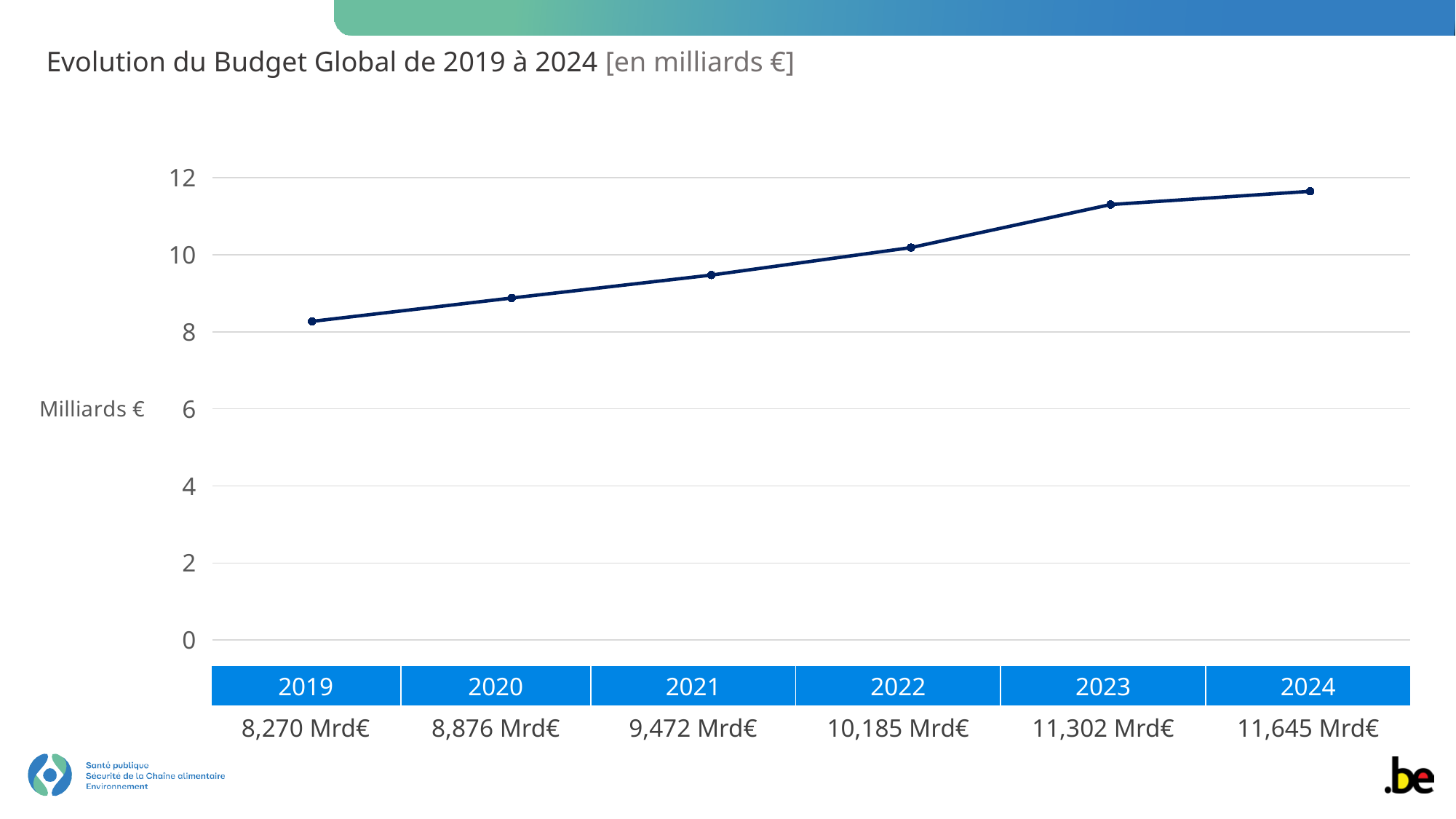
Does the global budget rise or fall from 2019 to 2024? rise What is the value of the global budget for 2024? 11,645 Mrd€ Which year has the lowest global budget? 2019 Which year has the highest global budget? 2024 What is the value of the global budget for 2022? 10,185 Mrd€ How many years are plotted on the chart? 6 Which year has a larger global budget, 2021 or 2023? 2023 What type of chart is shown on the slide? line chart Is the value for 2022 greater or less than 10? greater What is the difference between the global budget in 2024 and in 2019? 3,375 Mrd€ What is the value of the global budget for 2019? 8,270 Mrd€ What is the difference between the global budget in 2023 and in 2022? 1,117 Mrd€